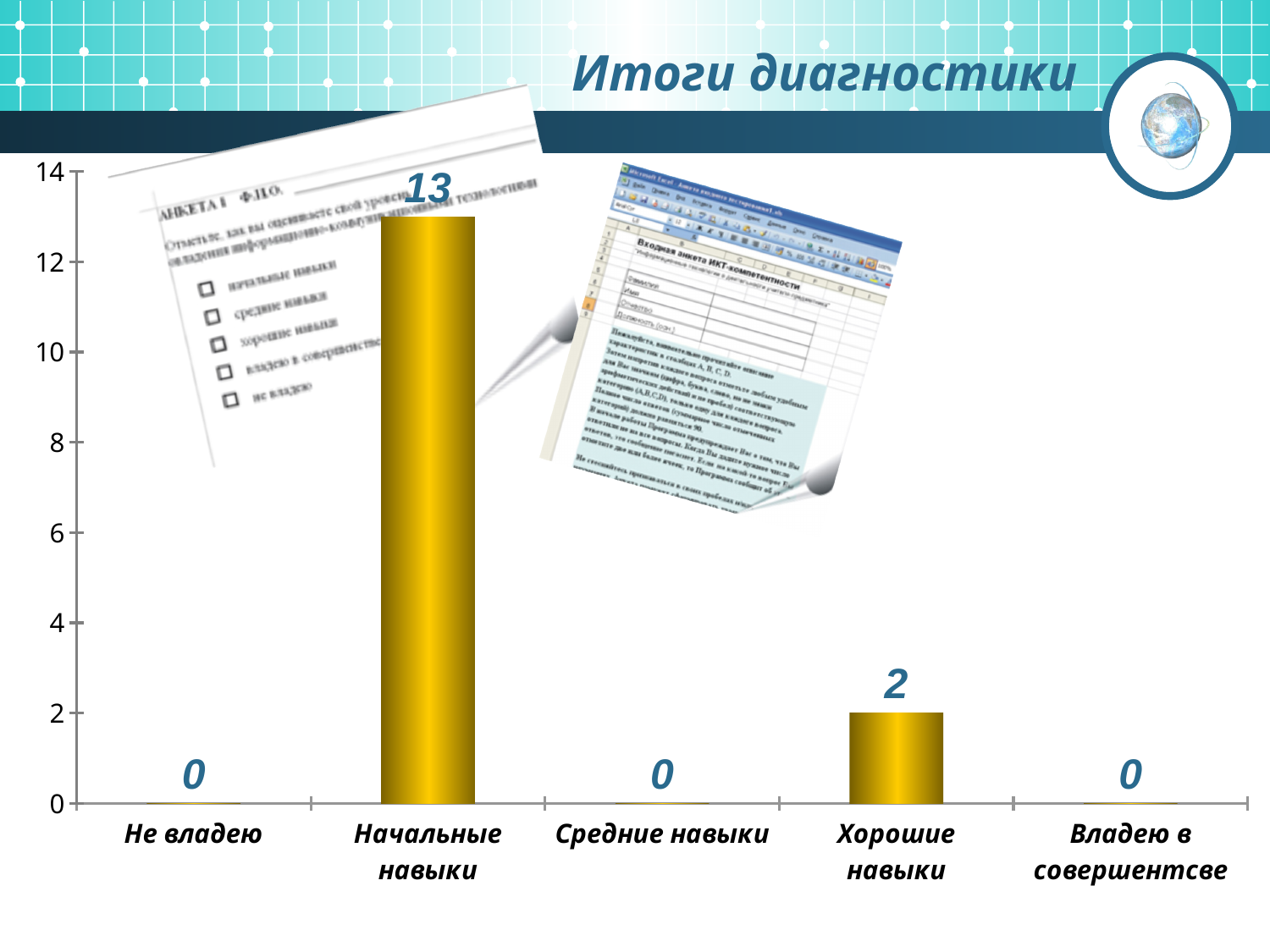
Which category has the highest value? Начальные навыки What kind of chart is shown on the slide? bar chart What is the value for Не владею? 0 What is the value for Хорошие навыки? 2 How many categories are shown on the x axis? 5 What is the difference between the values for Начальные навыки and Хорошие навыки? 11 Is the value for Начальные навыки greater or less than 10? greater How many categories have a value of 0? 3 What is the value for Средние навыки? 0 Which is larger, the value for Начальные навыки or the value for Хорошие навыки? Начальные навыки What is the title of the slide containing the chart? Итоги диагностики What is the value for Начальные навыки? 13